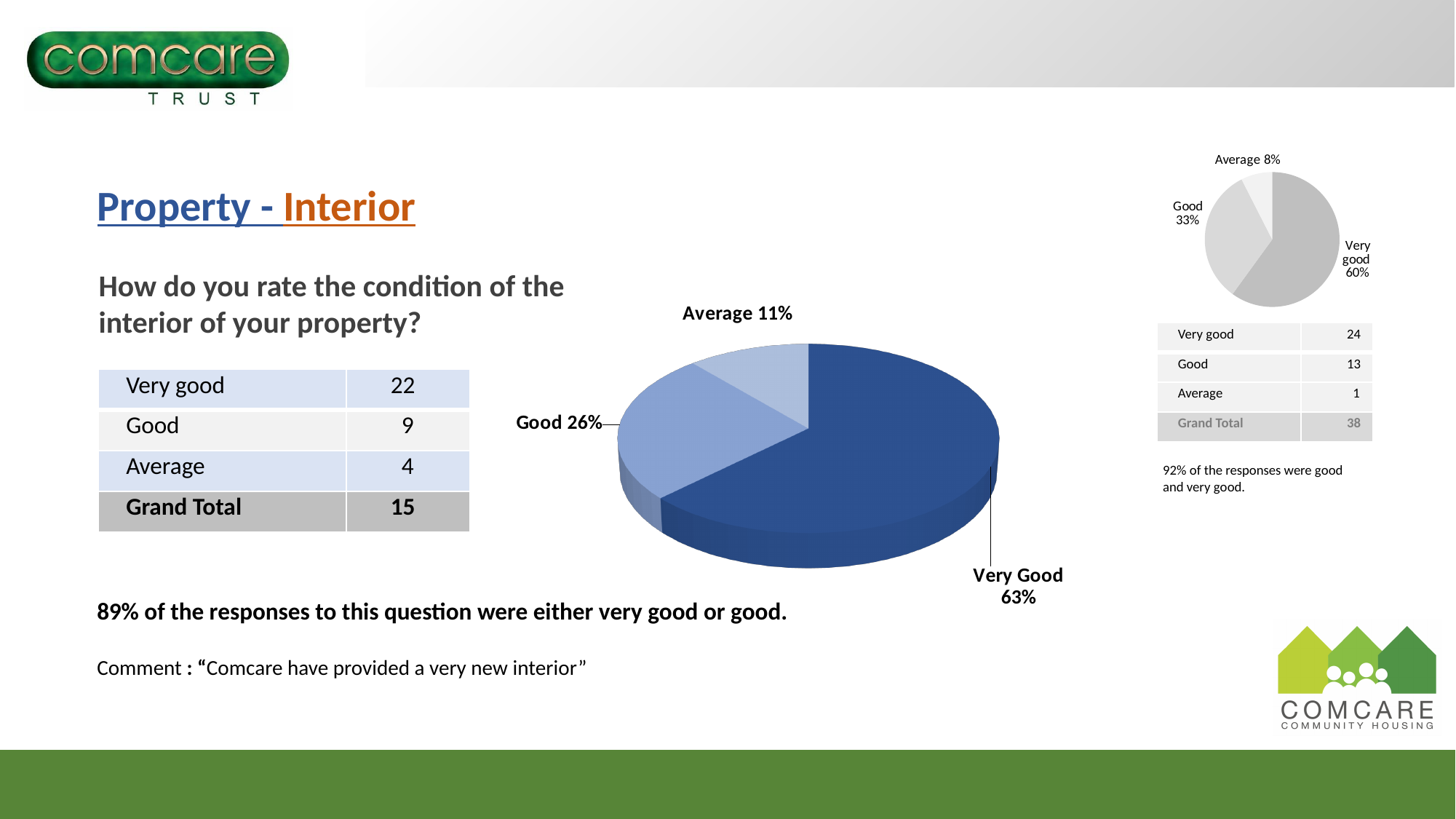
On the small grey pie chart at the top right, what share is labelled for Very good? 60% On the small grey pie chart at the top right, which category has the largest slice? Very good On the large blue pie chart in the centre, which category has the smallest slice? Average On the large blue pie chart in the centre, what share is labelled for Very Good? 63% What kind of chart is the large blue chart in the centre of the slide? Pie chart On the large blue pie chart in the centre, what share is labelled for Average? 11% On the large blue pie chart in the centre, how many slices are there? 3 On the large blue pie chart in the centre, which category has the largest slice? Very Good On the large blue pie chart in the centre, is the Very Good slice larger or smaller than the Good slice? Larger